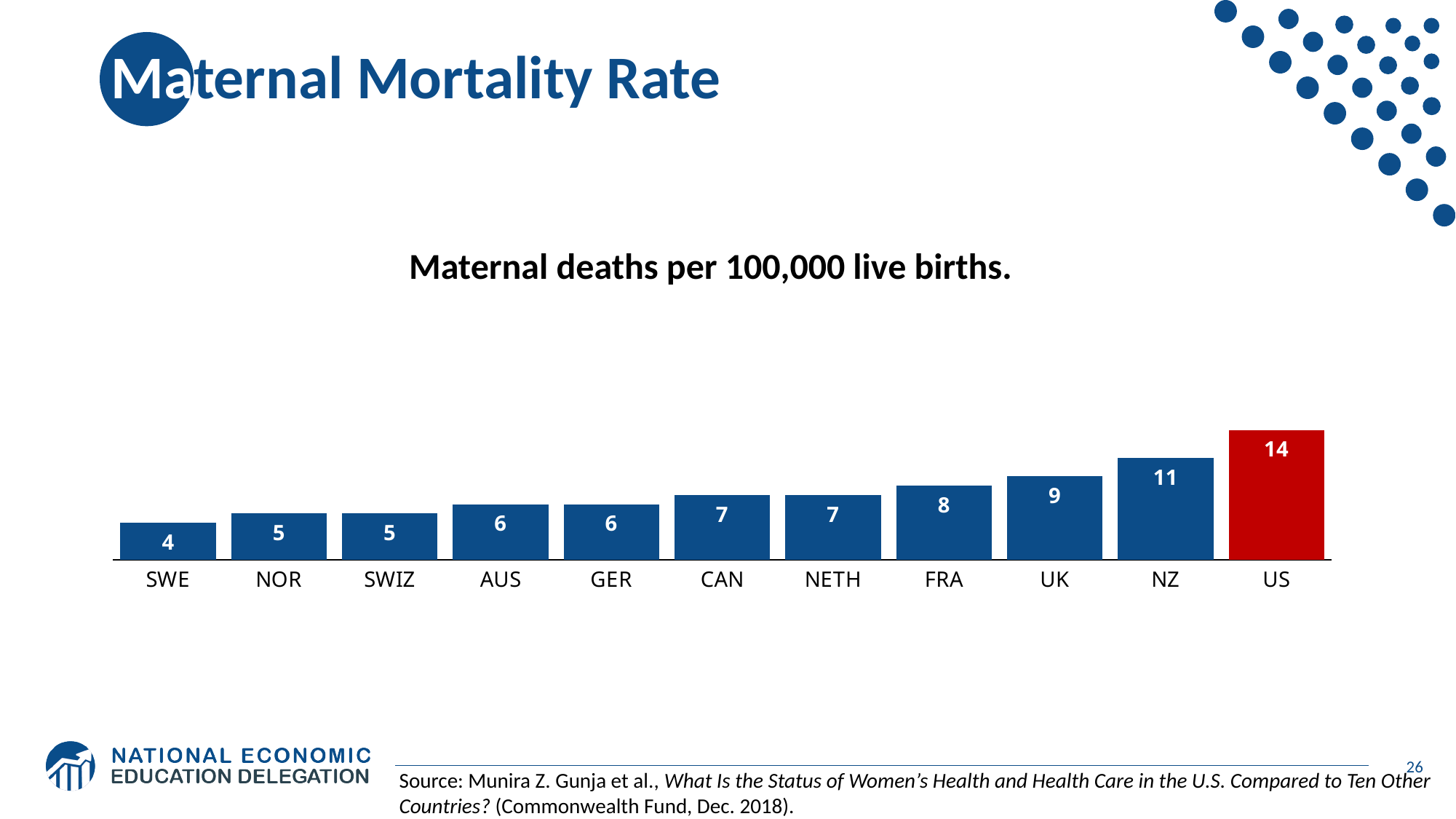
Which bar is coloured red rather than blue? US Which has a higher value, CAN or NOR? CAN Which country has the highest maternal mortality rate on the chart? US What is the difference between the values for NZ and SWE? 7 What is the value for NZ? 11 What kind of chart is shown on the slide? Bar chart How many countries are shown on the chart? 11 Which country has the lowest maternal mortality rate on the chart? SWE What value is shown for FRA? 8 What value is shown for SWE? 4 What is the maternal mortality rate shown for the US? 14 What is the difference between the values for the US and the UK? 5